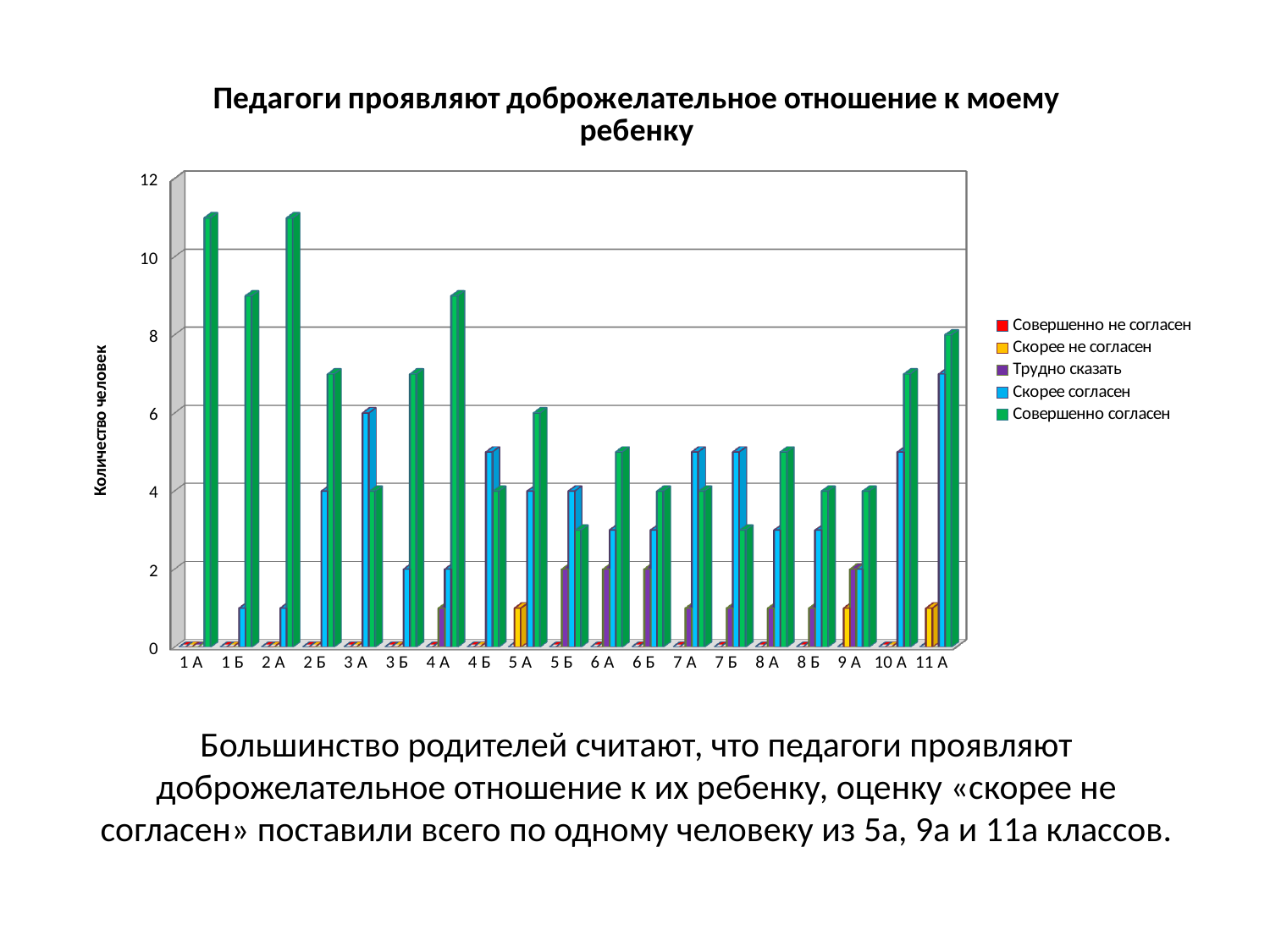
Is the value of «Скорее не согласен» for 5 А greater or less than 2? less What is the label of the vertical axis? Количество человек How many series does the legend list? 5 Is the value of «Совершенно согласен» for 11 А greater or less than 10? less What kind of chart is shown on the slide? bar chart Is the value of «Скорее согласен» for 3 А greater or less than 4? greater Which is larger: the «Совершенно согласен» value for 1 А or for 1 Б? 1 А Which is larger: the «Скорее согласен» value for 3 А or for 3 Б? 3 А What is the title of the chart? Педагоги проявляют доброжелательное отношение к моему ребенку How many class categories are shown along the x axis? 19